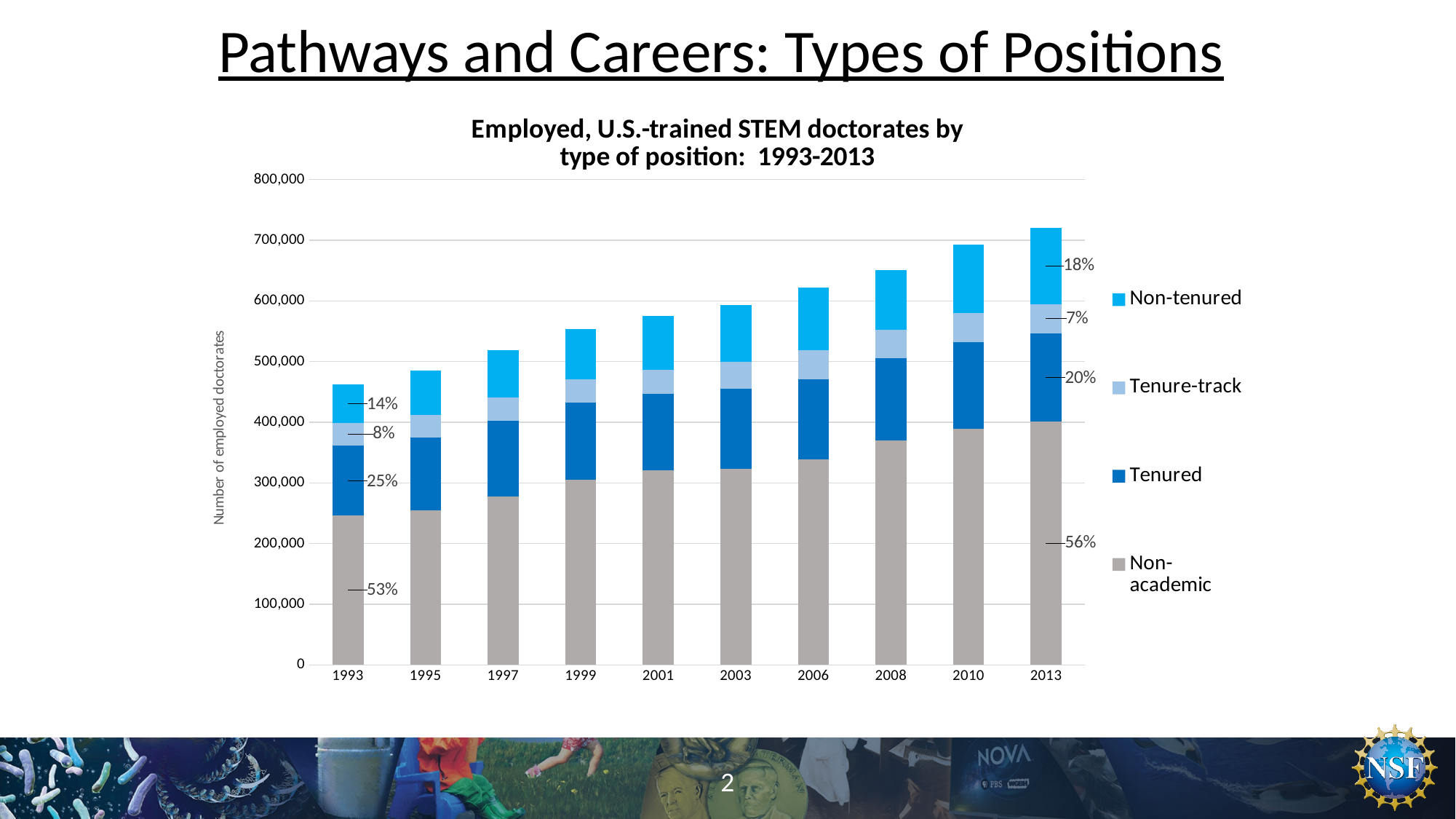
Which year has the highest total number of employed doctorates? 2013 What kind of chart is shown on the slide? Stacked bar chart Does the total number of employed doctorates rise or fall from 1993 to 2013? Rise Which year had the larger Tenured share, 1993 or 2013? 1993 How many series does the chart's legend list? 4 Is the total number of employed doctorates in 2013 greater or less than 700,000? greater What percentage of employed STEM doctorates were in Tenure-track positions in 2013? 7% What percentage of employed STEM doctorates were in Non-tenured positions in 2013? 18% How many years are shown along the x axis of the chart? 10 What percentage of employed STEM doctorates were in Non-academic positions in 1993? 53% By how many percentage points did the Non-academic share change from 1993 (53%) to 2013 (56%)? 3 percentage points What percentage of employed STEM doctorates were in Tenured positions in 1993? 25%